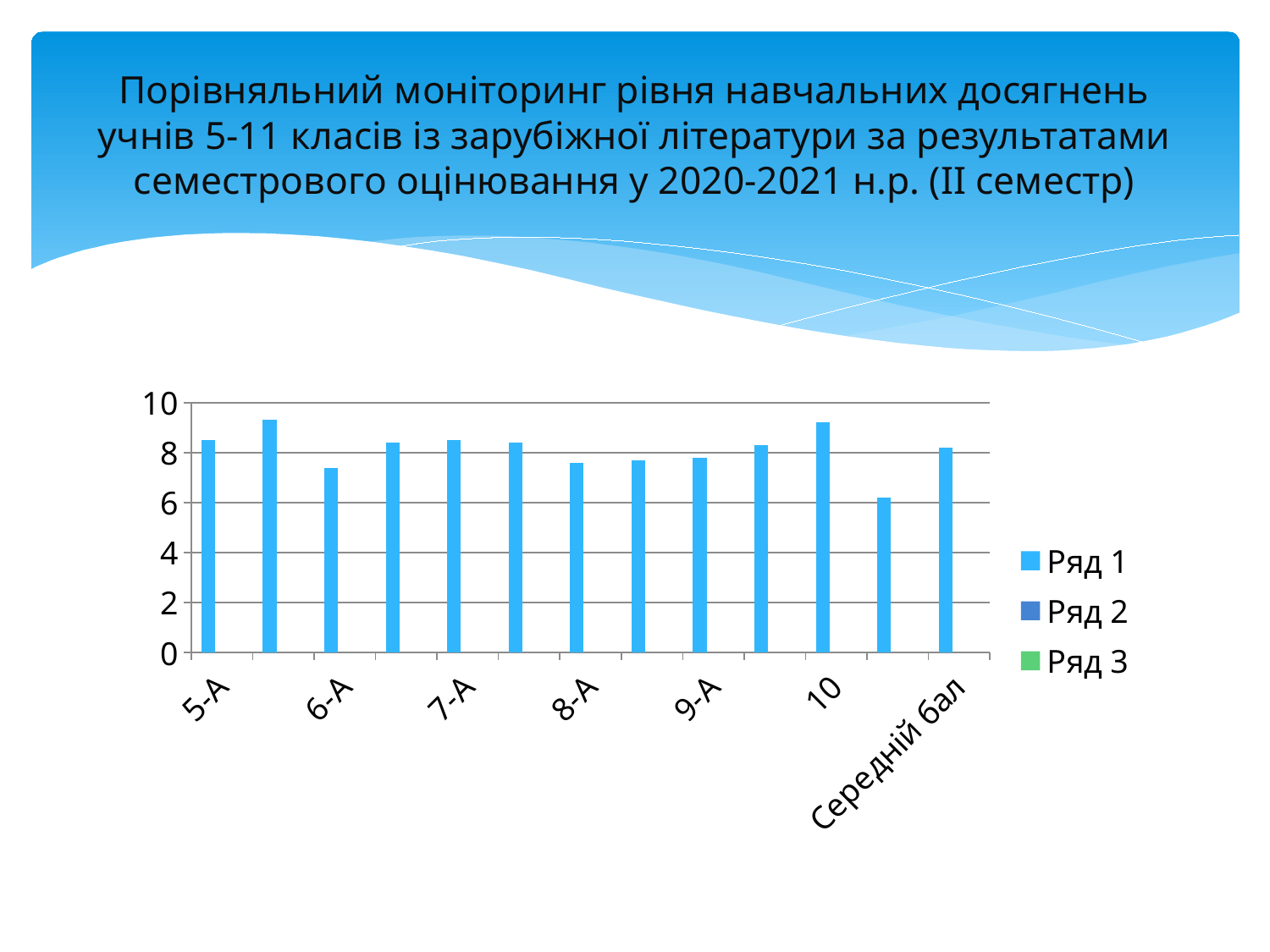
Is the value for 10 greater or less than 8? greater What is the highest value shown on the vertical axis? 10 Is the value for 5-А greater or less than 8? greater Which has the larger value, 5-А or 8-А? 5-А Is the value for 6-А greater or less than 8? less Which has the larger value, 10 or 6-А? 10 How many bars are plotted in the chart? 13 How many series does the legend list? 3 What are the entries listed in the legend? Ряд 1, Ряд 2, Ряд 3 What kind of chart is shown on the slide? bar chart